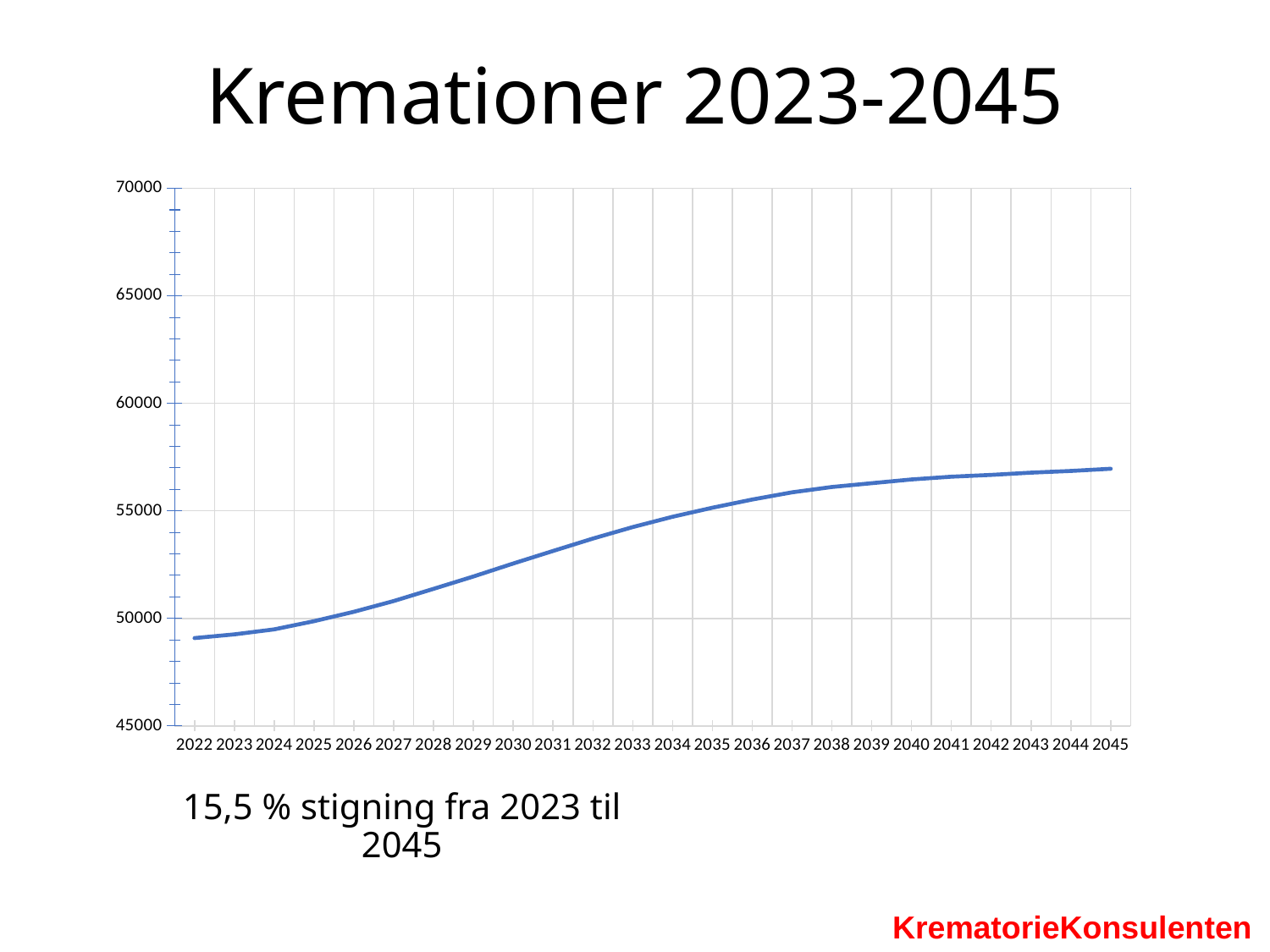
What is the title of the chart? Kremationer 2023-2045 Is the value for 2045 greater or less than 55000? greater Which year has the highest value? 2045 Is the value for 2040 greater or less than 60000? less What kind of chart is shown on the slide? line chart How many years are shown on the x axis? 24 Do the values rise or fall from 2022 to 2045? rise Which year has the lowest value? 2022 Which is larger, the value for 2035 or the value for 2025? 2035 Is the value for 2022 greater or less than 50000? less What percentage increase from 2023 to 2045 does the text below the chart state? 15,5 %